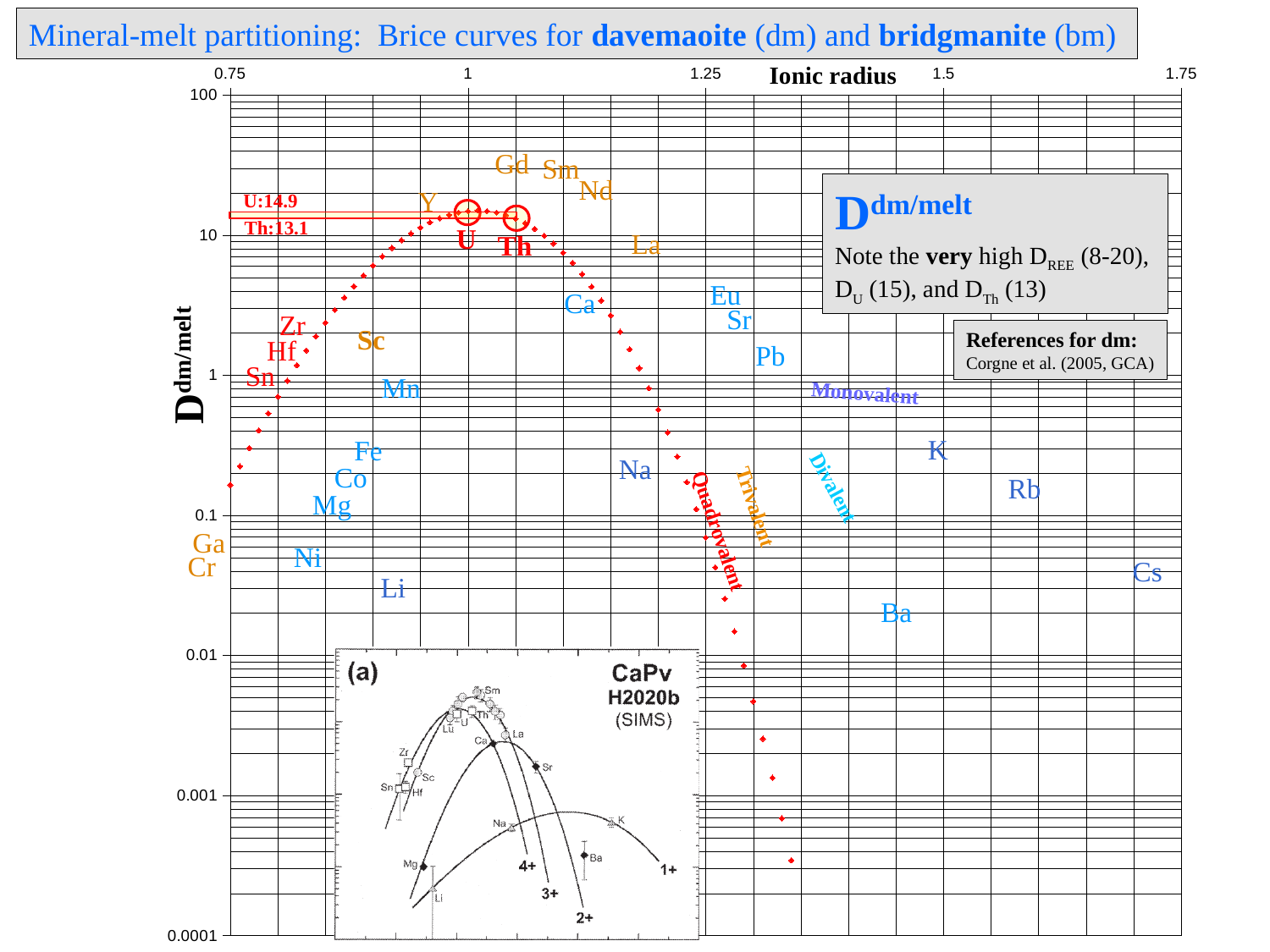
Is the value for Ba greater or less than 0.1? less Is the value for Gd greater or less than 10? greater What value is printed for Th on the chart? 13.1 Is the value for Ca greater or less than 1? greater What is the lowest value shown on the y axis? 0.0001 What is the difference between the printed D values for U (14.9) and Th (13.1)? 1.8 Do the red data points rise or fall as ionic radius increases beyond about 1.1? fall What is the label of the x axis? Ionic radius What value is printed for U on the chart? 14.9 Which has the larger printed D value, U or Th? U